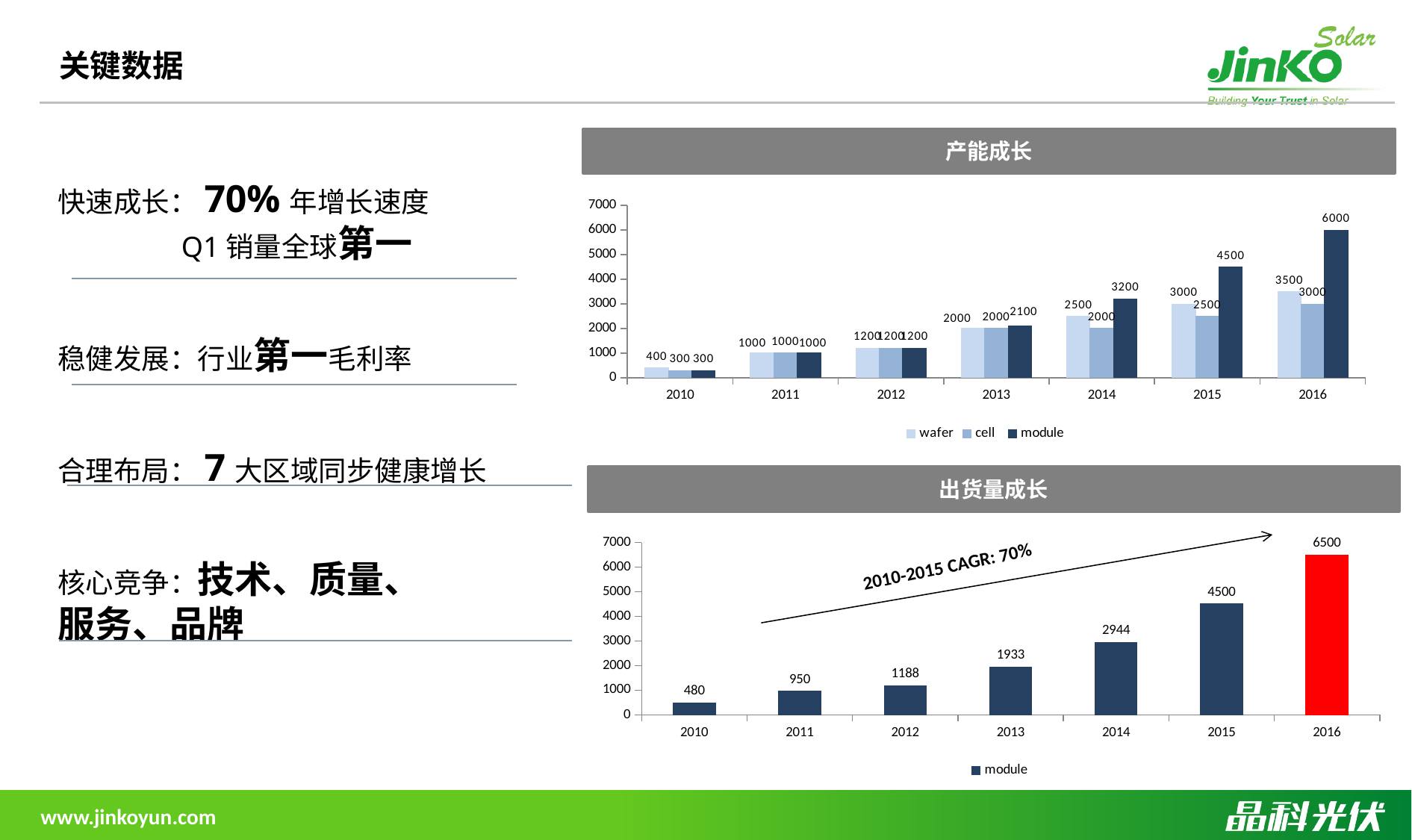
In the 出货量成长 chart, what is the value for 2014? 2944 In the 产能成长 chart, how many series does the legend list? 3 In the 产能成长 chart, what is the wafer value for 2014? 2500 In the 产能成长 chart, what is the difference between the module value and the cell value in 2016? 3000 In the 产能成长 chart, what is the module value for 2016? 6000 What type of chart is the 出货量成长 chart? bar chart In the 出货量成长 chart, how many years are shown on the x axis? 7 In the 出货量成长 chart, what is the difference between the 2015 and 2013 values? 2567 In the 出货量成长 chart, do the values rise or fall from 2010 to 2016? rise In the 产能成长 chart, what is the cell value for 2015? 2500 In the 出货量成长 chart, which year has the highest value? 2016 In the 产能成长 chart, which year has the lowest wafer value? 2010